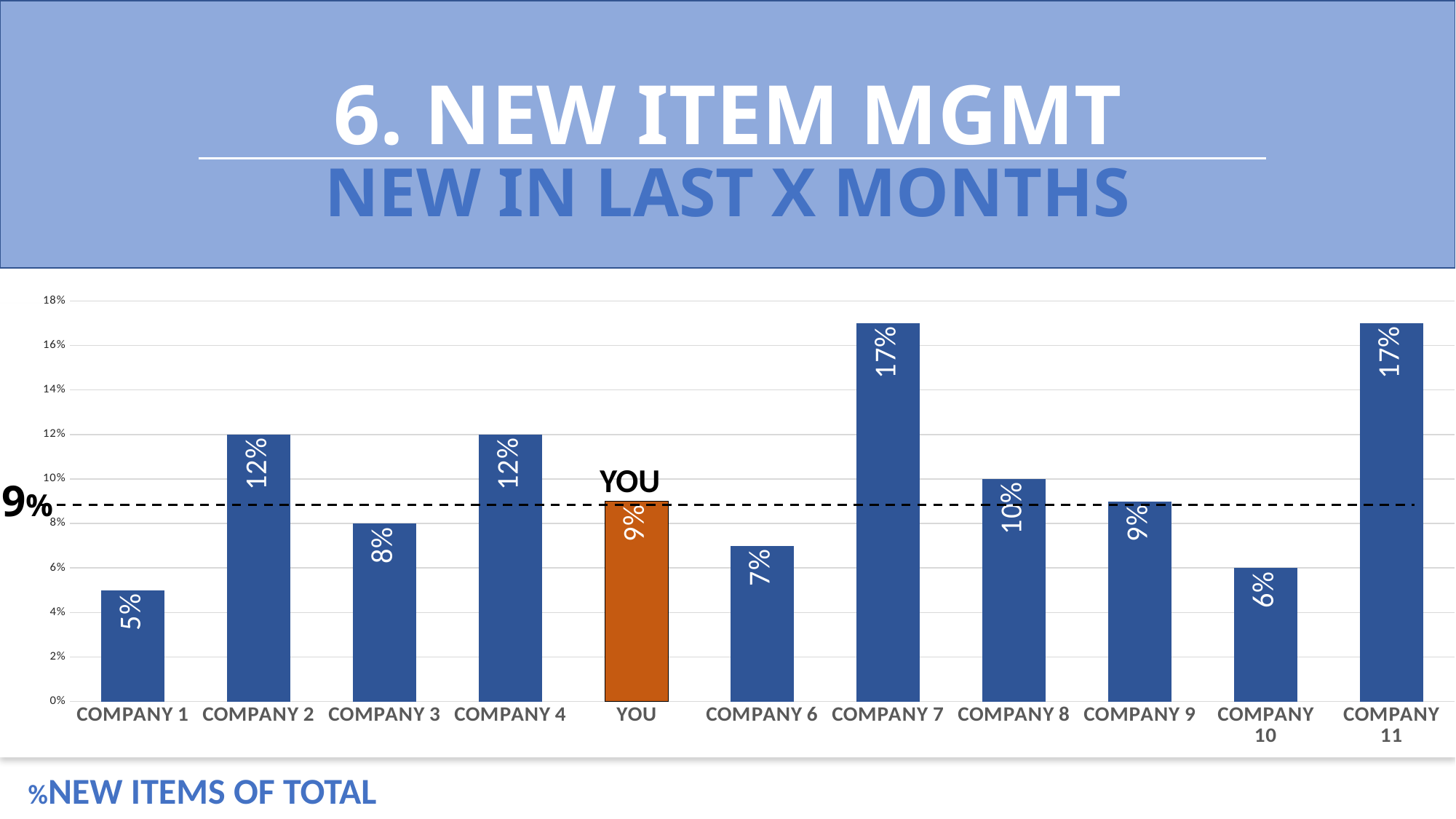
What is the difference between the values for COMPANY 4 and COMPANY 6? 5% How many categories are shown on the x axis? 11 What is the difference between the values for COMPANY 7 and YOU? 8% What kind of chart is shown on the slide? bar chart What value does the dashed horizontal line mark? 9% What is the value for COMPANY 10? 6% Which is larger, the value for COMPANY 3 or the value for COMPANY 8? COMPANY 8 Which category has the lowest value? COMPANY 1 What is the value for YOU? 9% Is the value for COMPANY 11 greater or less than 14%? greater Which bar is coloured orange instead of blue? YOU What is the value for COMPANY 2? 12%